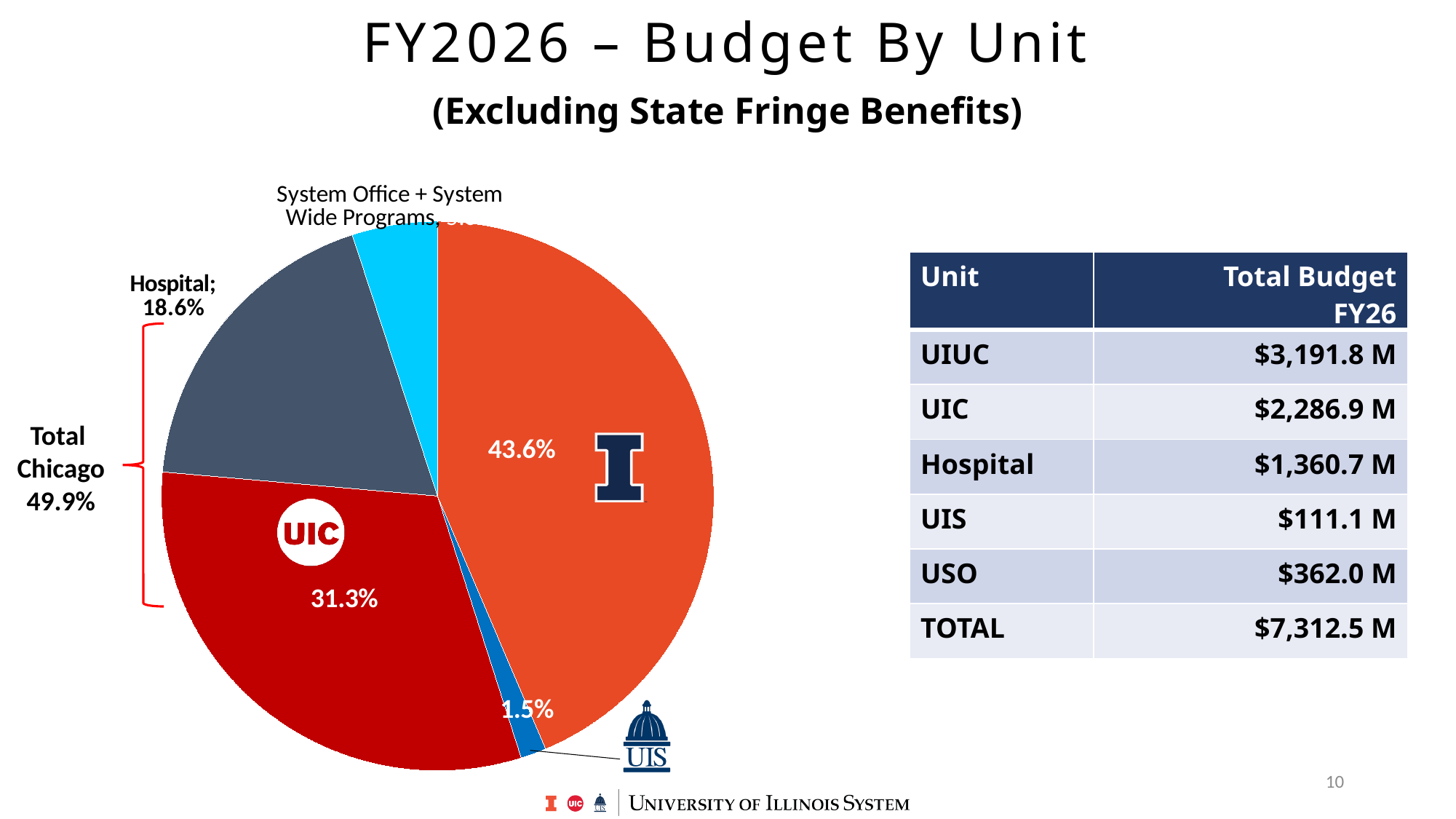
What combined share is labelled as Total Chicago on the pie chart? 49.9% How many slices does the pie chart have? 5 What share of the pie does the Hospital slice represent? 18.6% Which is larger, the Hospital slice or the UIC slice? UIC What is the difference in percentage points between the UIUC slice and the UIC slice? 12.3 percentage points Which slice of the pie is the smallest? UIS (1.5%) What kind of chart is shown on the slide? pie chart What is the title of the slide containing the pie chart? FY2026 – Budget By Unit (Excluding State Fringe Benefits) What share of the pie does the UIC slice (red) represent? 31.3% Which slice of the pie is the largest? UIUC (43.6%) What share of the pie does the UIUC slice (orange, with the block I logo) represent? 43.6%